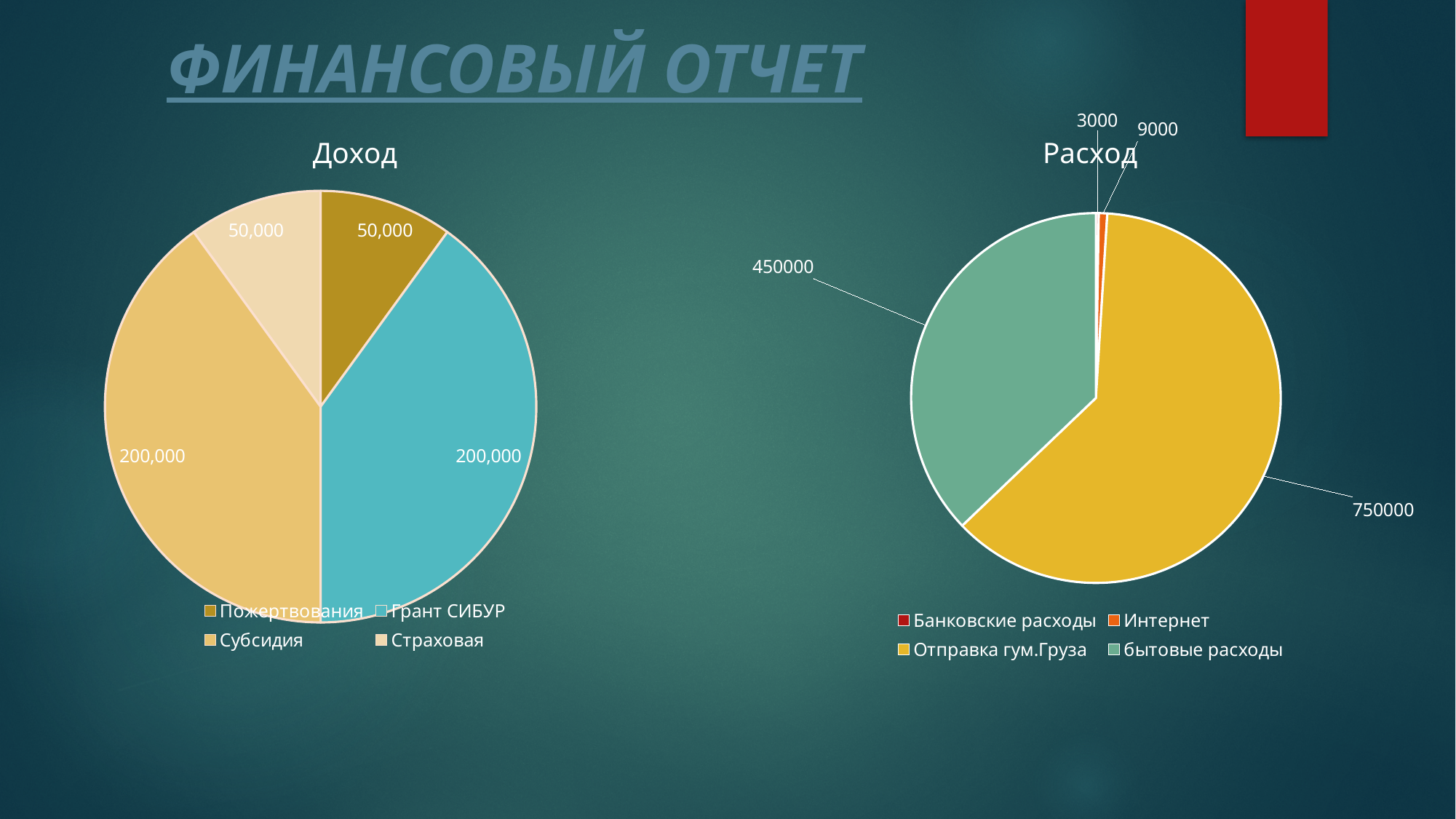
In the Доход chart, what is the value for Страховая? 50,000 In the Доход chart, what is the difference between Субсидия and Пожертвования? 150,000 In the Расход chart, what is the value for Отправка гум.Груза? 750000 In the Доход chart, which is larger, Грант СИБУР or Страховая? Грант СИБУР What type of chart is the Доход chart? Pie chart In the Расход chart, which category has the highest value? Отправка гум.Груза In the Расход chart, what is the value for Интернет? 9000 How many categories does the Расход chart's legend list? 4 In the Расход chart, which category has the lowest value? Банковские расходы In the Расход chart, what is the difference between Отправка гум.Груза and бытовые расходы? 300000 In the Доход chart, what share of the total does Пожертвования represent? 10% In the Доход chart, what is the value for Грант СИБУР? 200,000